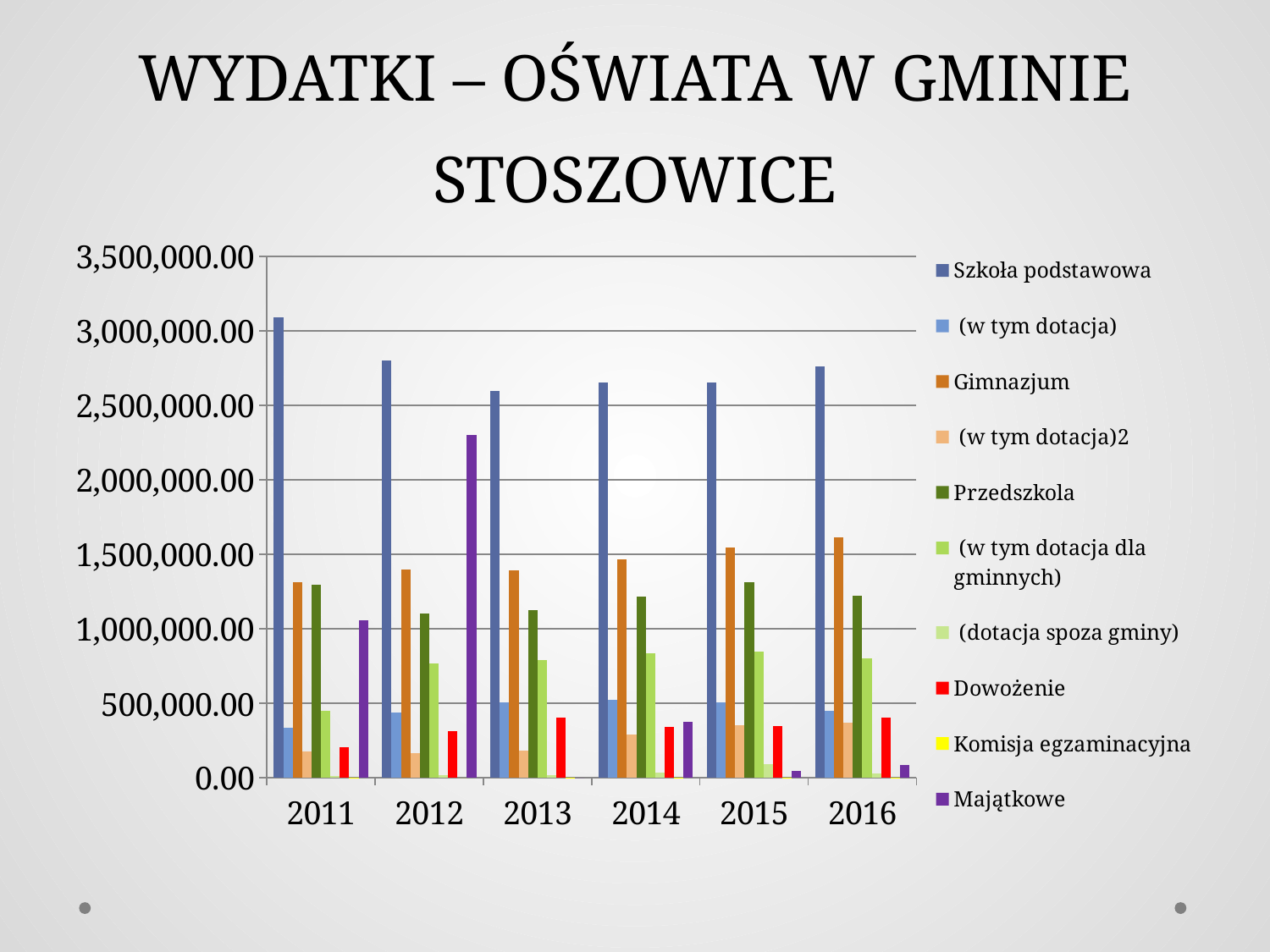
How many years are shown on the x axis of the chart? 6 In 2016, which is larger: Gimnazjum or Przedszkola? Gimnazjum Is the value for Szkoła podstawowa in 2011 greater or less than 3,000,000.00? greater How many series does the chart's legend list? 10 In which year is the value for Majątkowe the highest? 2012 What is the title of the slide containing the chart? WYDATKI – OŚWIATA W GMINIE STOSZOWICE Is the value for Majątkowe in 2012 greater or less than 2,000,000.00? greater Do the values for Gimnazjum rise or fall from 2011 to 2016? rise Which is larger: Szkoła podstawowa in 2011 or Szkoła podstawowa in 2012? 2011 Is the value for Dowożenie in 2011 greater or less than 500,000.00? less In which year is the value for Szkoła podstawowa the highest? 2011 What kind of chart is shown on the slide? Bar chart